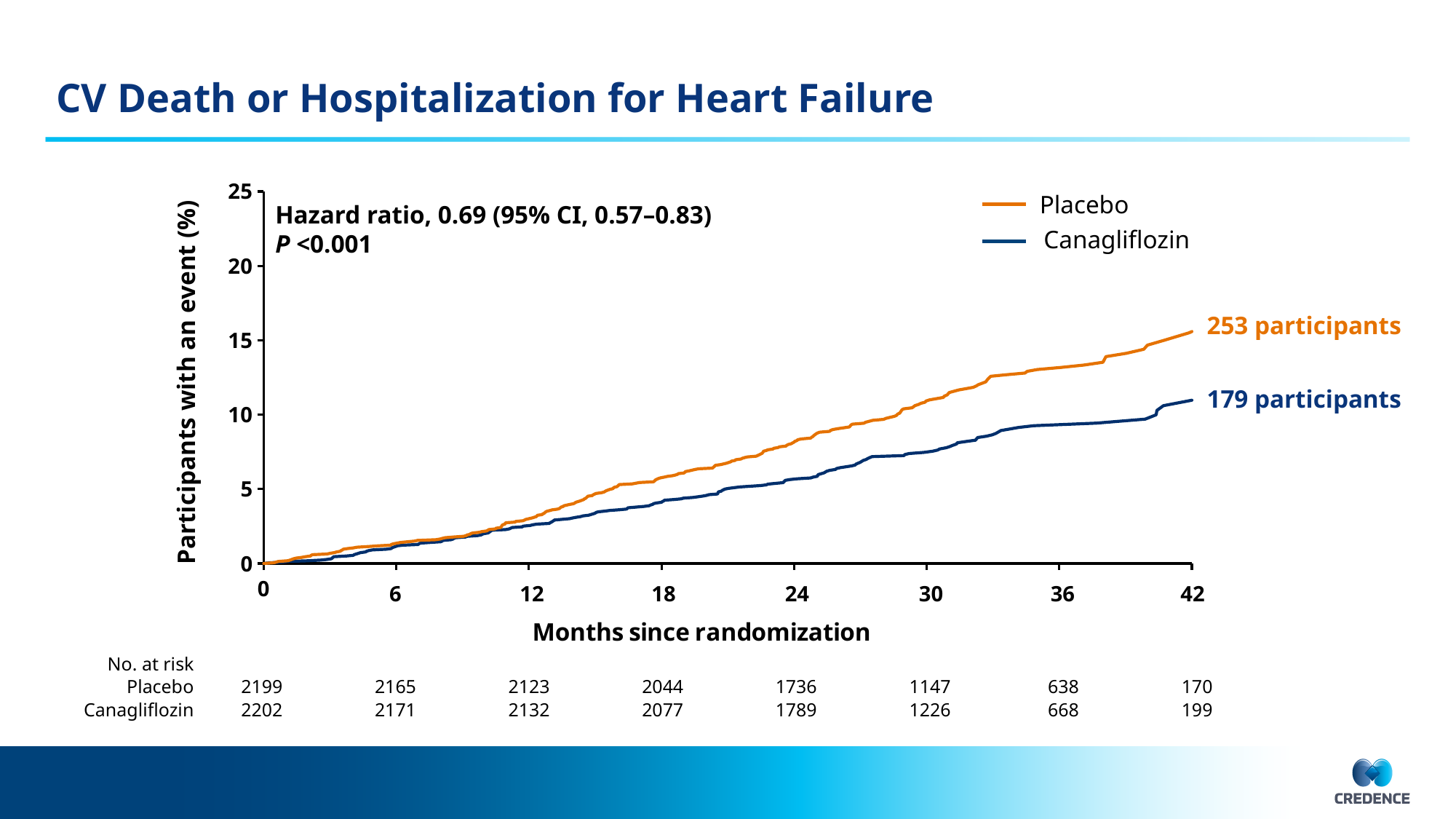
What is the number at risk for Placebo at 42 months? 170 What is the hazard ratio shown on the chart? 0.69 Is the value for Canagliflozin at 42 months greater or less than 10? greater Do the values for both groups rise or fall as months since randomization increase? rise How many participants had an event in the Placebo group? 253 participants Which group has the higher percentage of participants with an event at 42 months, Placebo or Canagliflozin? Placebo What is the difference in the number of participants with an event between the Placebo and Canagliflozin groups? 74 How many participants had an event in the Canagliflozin group? 179 participants How many series does the legend list? 2 Is the value for Placebo at 24 months greater or less than 10? less What is the number at risk for Canagliflozin at 24 months? 1789 What kind of chart is shown on the slide? line chart